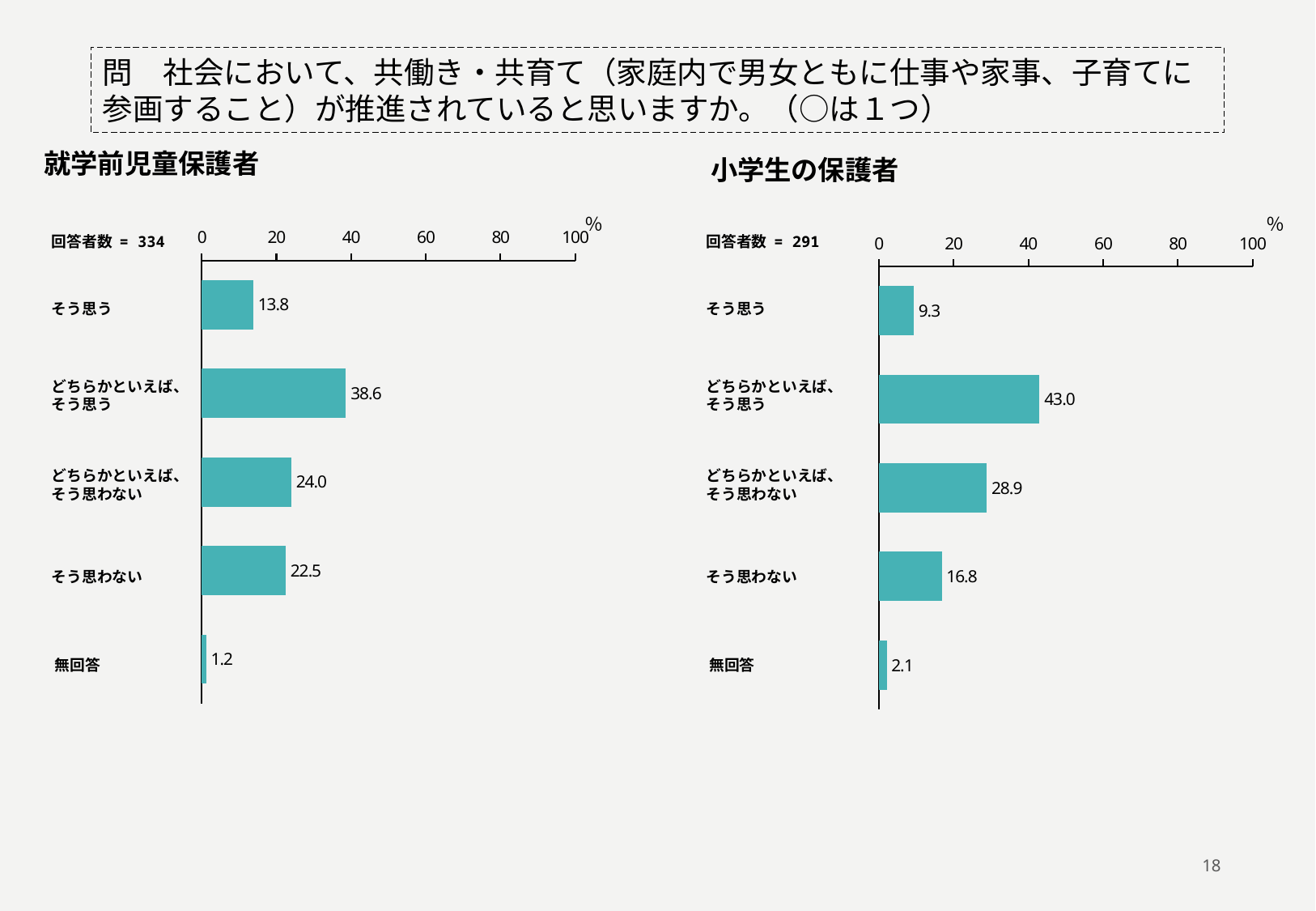
In the 就学前児童保護者 chart, what is the value for そう思う? 13.8 In the 小学生の保護者 chart, what is the difference between そう思わない and そう思う? 7.5 What kind of chart is the 小学生の保護者 chart? bar chart In the 小学生の保護者 chart, which category has the lowest value? 無回答 In the 就学前児童保護者 chart, which category has the highest value? どちらかといえば、そう思う In the 就学前児童保護者 chart, what is the difference between どちらかといえば、そう思う and どちらかといえば、そう思わない? 14.6 In the 小学生の保護者 chart, what is the value for どちらかといえば、そう思う? 43.0 In the 就学前児童保護者 chart, which is larger: どちらかといえば、そう思わない or そう思わない? どちらかといえば、そう思わない What is the number of respondents (回答者数) shown for the 就学前児童保護者 chart? 334 How many categories does the 就学前児童保護者 chart show? 5 In the 小学生の保護者 chart, is the value for どちらかといえば、そう思う greater or less than 40? greater In the 小学生の保護者 chart, what is the value for 無回答? 2.1